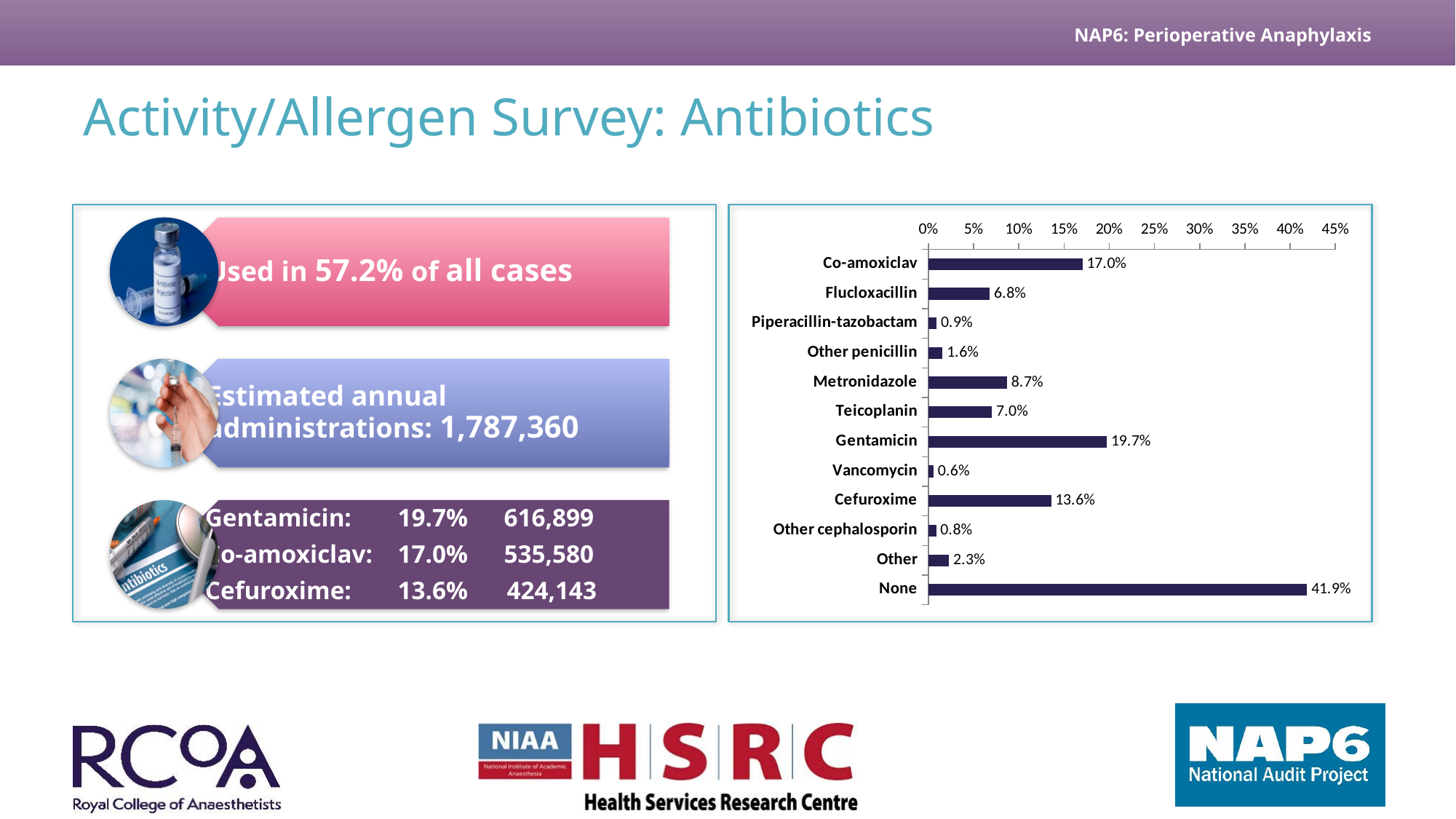
What kind of chart is shown on the slide? Bar chart What is the highest value shown on the x axis of the bar chart? 45% What is the value for Vancomycin in the bar chart? 0.6% What is the value for Co-amoxiclav in the bar chart? 17.0% What is the value for Metronidazole in the bar chart? 8.7% What is the value for Other cephalosporin in the bar chart? 0.8% How many categories are shown in the bar chart? 12 What is the difference between the values for Gentamicin and Cefuroxime in the bar chart? 6.1% Which has a larger value in the bar chart, Flucloxacillin or Teicoplanin? Teicoplanin Which category has the lowest value in the bar chart? Vancomycin Which category has the highest value in the bar chart? None Is the value for None in the bar chart greater or less than 40%? greater